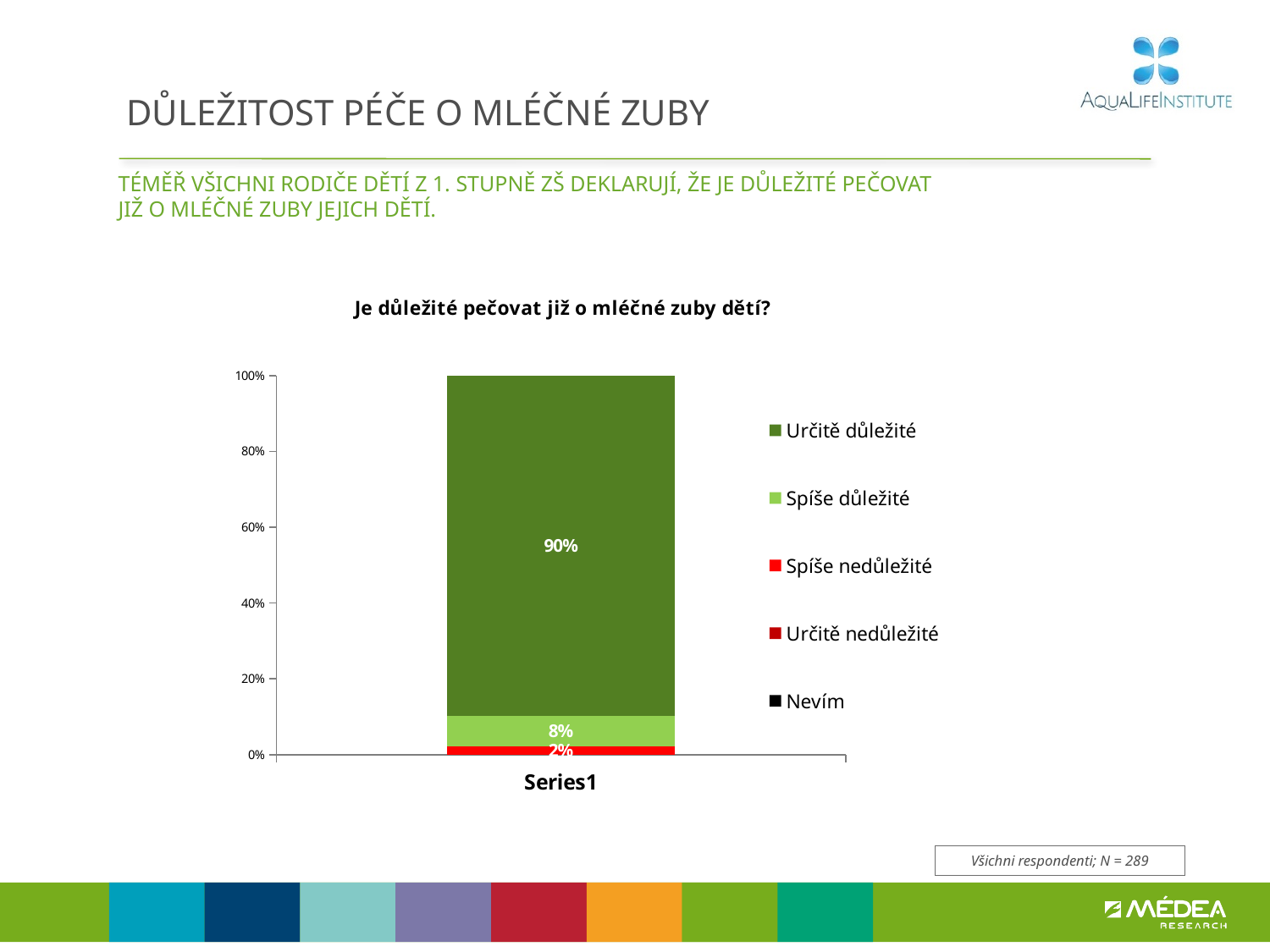
How many series does the legend list? 5 Which is larger, the value for "Spíše důležité" or the value for "Spíše nedůležité"? Spíše důležité What colour is the "Spíše nedůležité" segment? red What kind of chart is shown on the slide? stacked bar chart Is the value for "Určitě důležité" greater or less than 80%? greater What is the chart's title? Je důležité pečovat již o mléčné zuby dětí? What is the difference between the values for "Určitě důležité" and "Spíše důležité"? 82% What is the value for "Určitě důležité"? 90% What is the total of the three labelled segments in the bar (90%, 8% and 2%)? 100% What is the value for "Spíše důležité"? 8% What is the value for "Spíše nedůležité"? 2% Which series has the largest segment in the bar? Určitě důležité